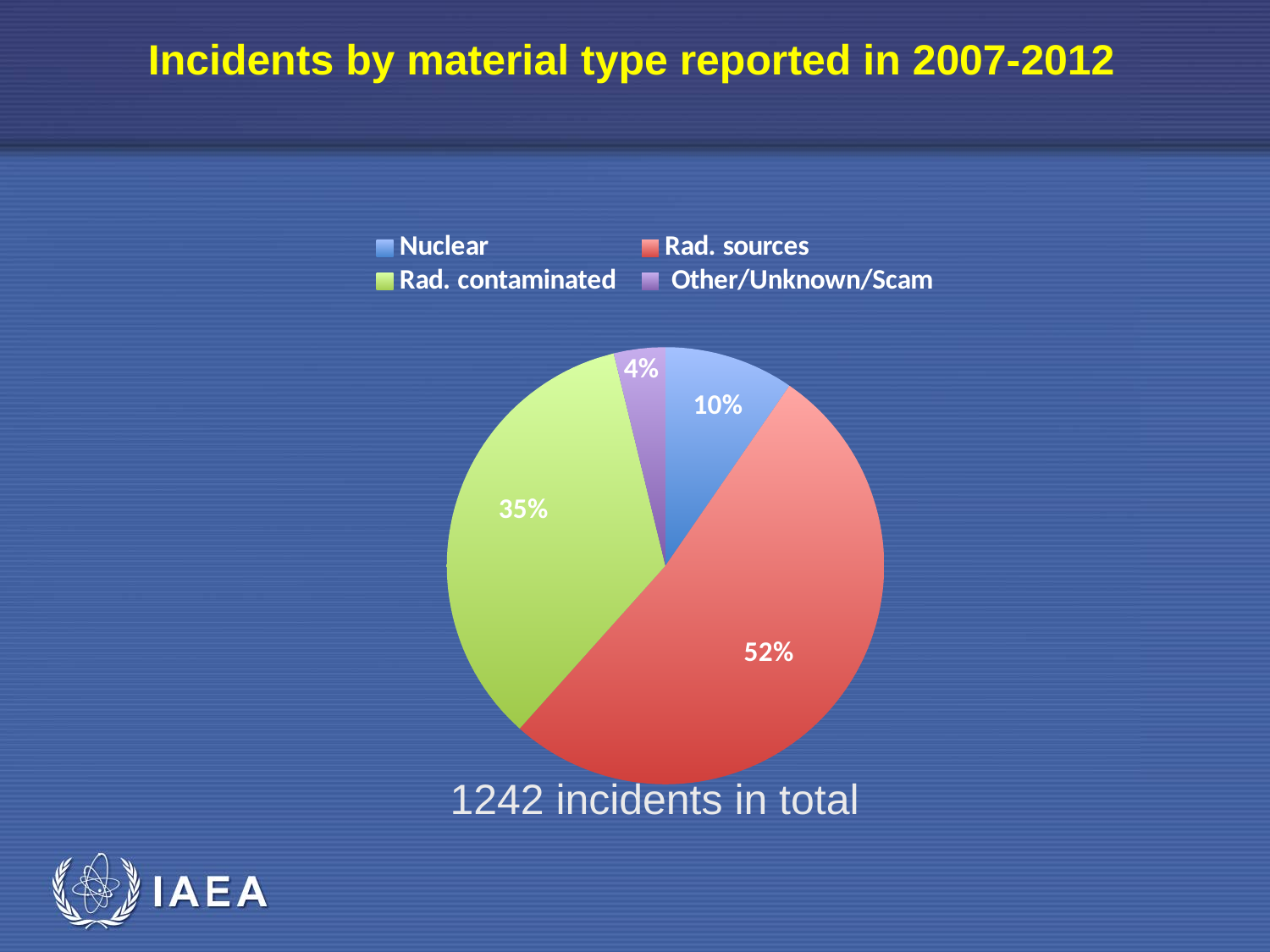
Which material type accounts for the smallest share of incidents? Other/Unknown/Scam What is the title of the slide? Incidents by material type reported in 2007-2012 What share of incidents is attributed to Rad. sources? 52% What kind of chart is shown on the slide? pie chart How many categories does the pie chart show? 4 Which has a larger share, Nuclear or Other/Unknown/Scam? Nuclear What share of incidents is attributed to Nuclear material? 10% What share of incidents falls under Other/Unknown/Scam? 4% Which material type accounts for the largest share of incidents? Rad. sources What is the difference in percentage points between the Rad. sources share and the Rad. contaminated share? 17% How many incidents in total does the slide report? 1242